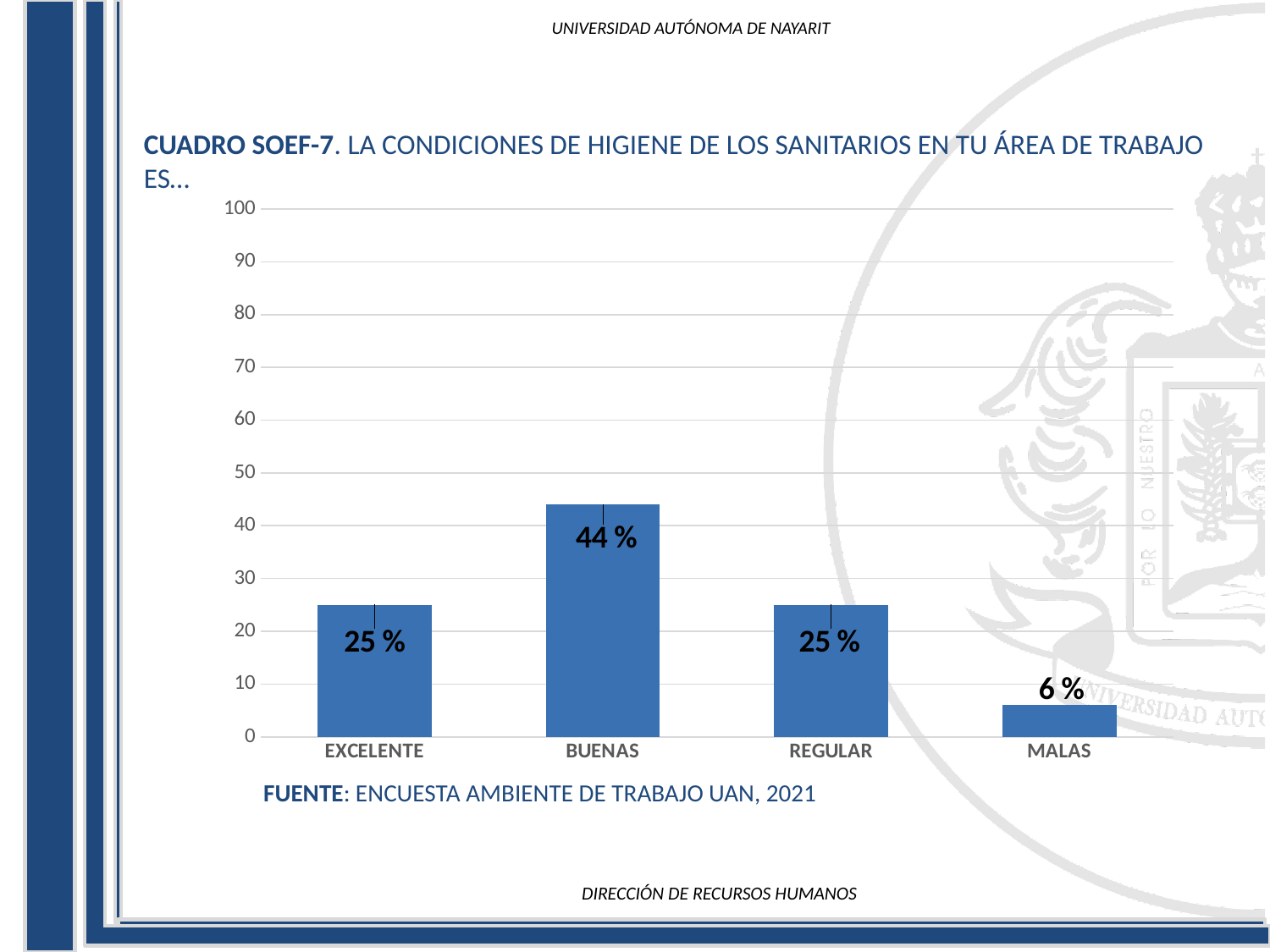
What is the value for BUENAS? 44 % What is the value for MALAS? 6 % Is the value for BUENAS greater or less than 40? greater What is the difference between the values for BUENAS and REGULAR? 19 % Which category has the lowest value? MALAS Which category has the highest value? BUENAS What is the value for EXCELENTE? 25 % How many categories are shown on the x axis? 4 What kind of chart is shown on the slide? bar chart What source is cited below the chart? ENCUESTA AMBIENTE DE TRABAJO UAN, 2021 Which is larger, the value for BUENAS or the value for MALAS? BUENAS Is the value for MALAS greater or less than 10? less